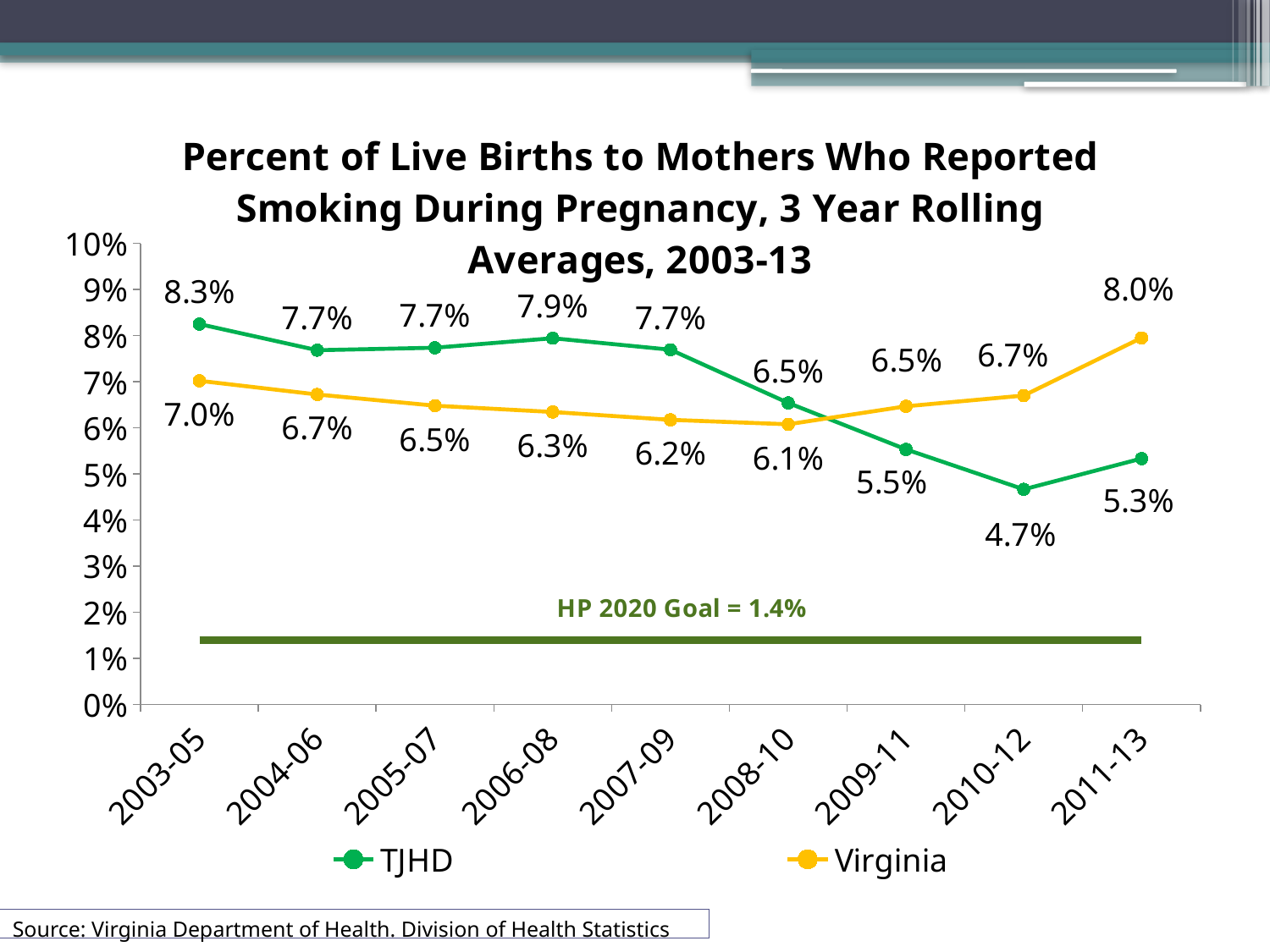
What is the TJHD value for 2003-05? 8.3% Which series has the larger value in 2011-13, TJHD or Virginia? Virginia How many periods are shown on the x axis? 9 In which period is the Virginia value highest? 2011-13 What is the HP 2020 Goal shown on the chart? 1.4% What is the TJHD value for 2010-12? 4.7% What kind of chart is this? Line chart In which period is the TJHD value lowest? 2010-12 How many series does the legend list? 2 What is the Virginia value for 2011-13? 8.0% What is the difference between the TJHD and Virginia values in 2003-05? 1.3% What is the Virginia value for 2008-10? 6.1%